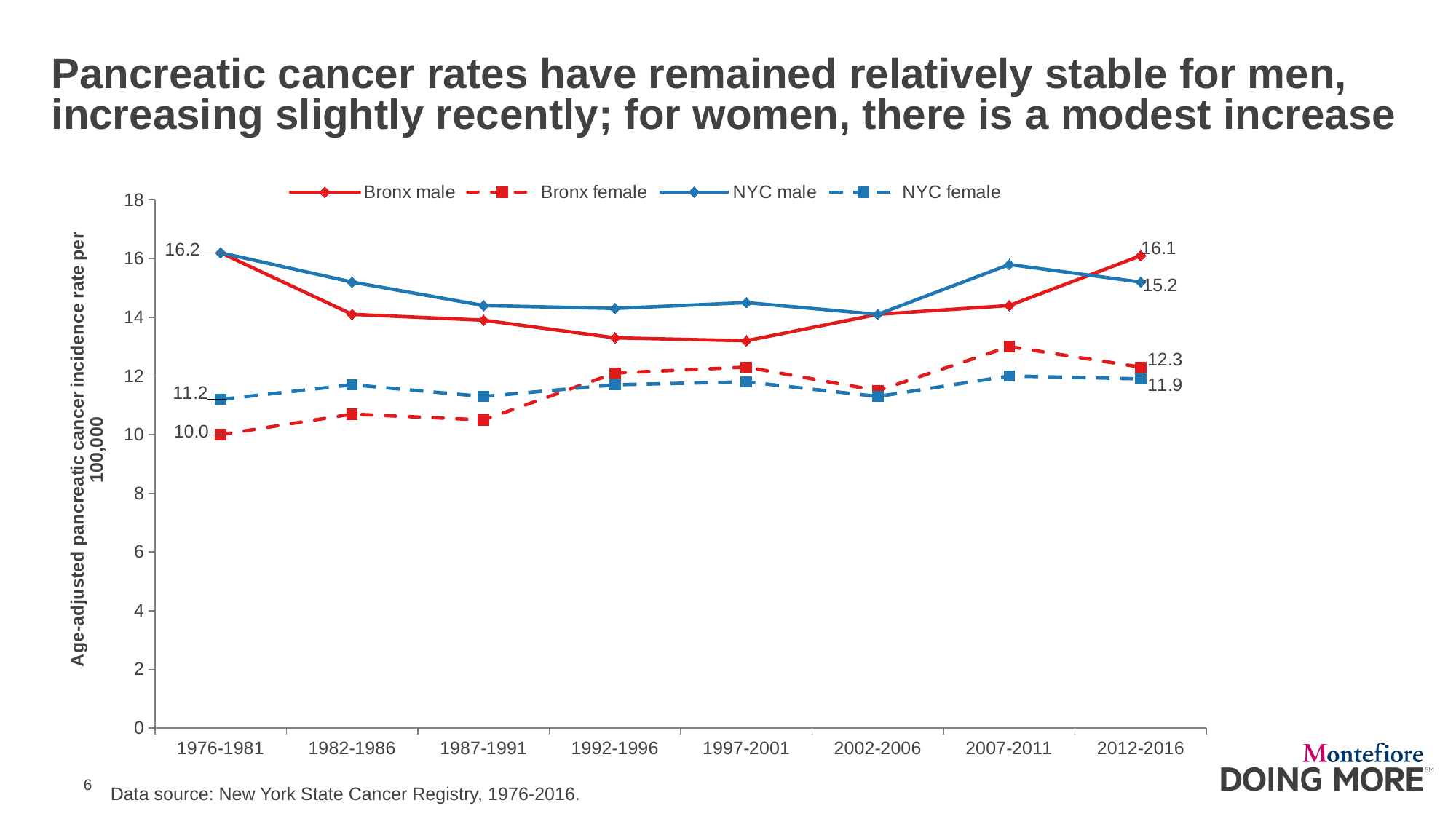
What is the value for NYC male in 2012-2016? 15.2 Which series has the higher value in 2012-2016, Bronx female or NYC female? Bronx female How many time periods are shown on the x axis? 8 How many series does the legend list? 4 What is the value for NYC female in 2012-2016? 11.9 Which series has the lowest value in 1976-1981? Bronx female What kind of chart is shown on the slide? line chart What is the value for Bronx female in 1976-1981? 10.0 Is the value for NYC male in 2007-2011 greater or less than 14? greater What is the value for Bronx male in 2012-2016? 16.1 What is the difference between the Bronx male and NYC male values in 2012-2016? 0.9 What is the difference between the NYC female and Bronx female values in 1976-1981? 1.2